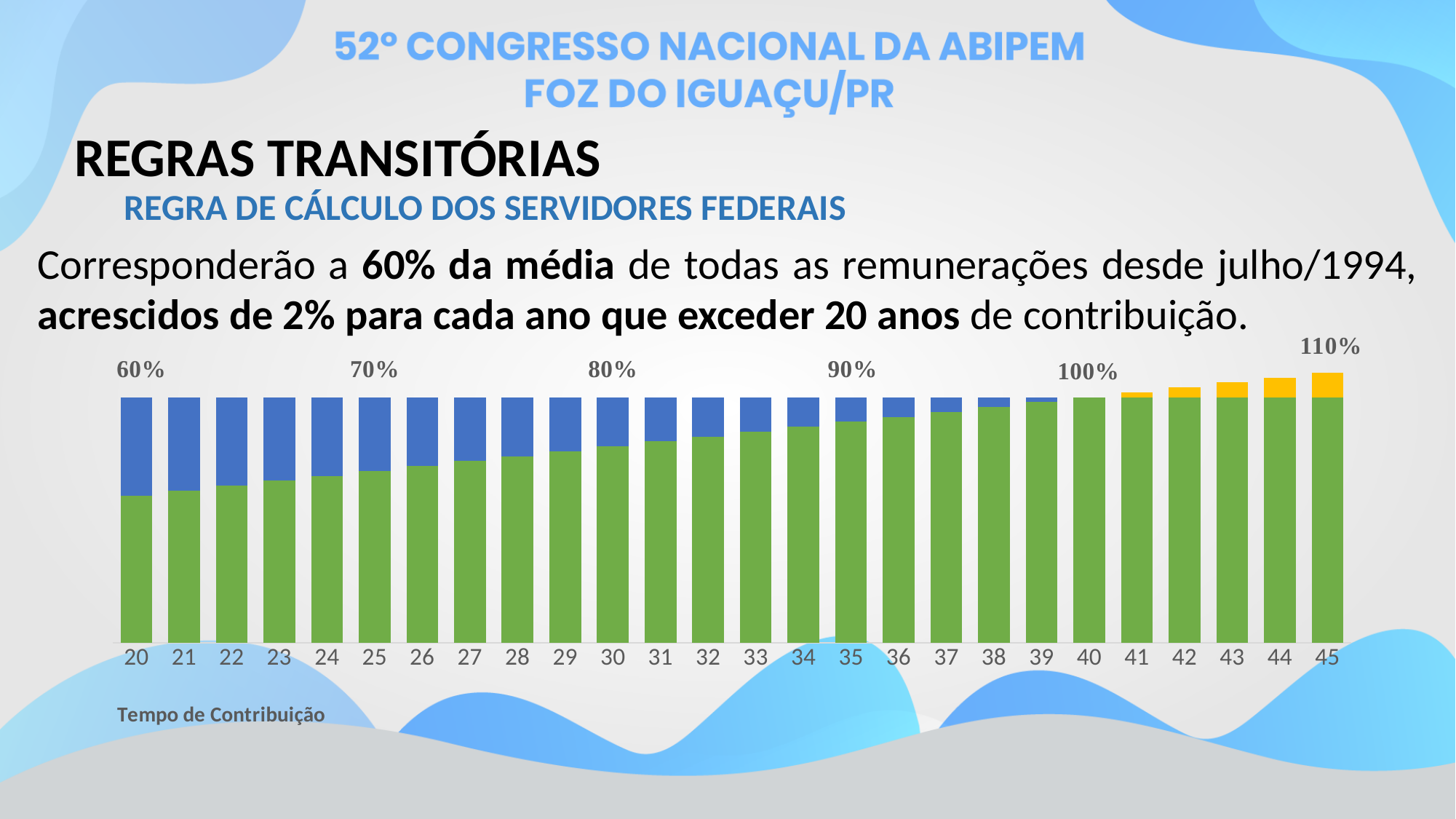
Which has a taller green bar: 25 years or 35 years of contribution? 35 What percentage is labelled above the bar for 40 years of contribution? 100% What is the difference between the labelled percentage at 45 years and at 20 years of contribution? 50% What percentage is labelled above the bar for 20 years of contribution? 60% Which contribution time has the shortest green bar? 20 Do the green bars rise or fall as the contribution time increases from 20 to 45 years? rise How many contribution-time categories are shown on the x axis of the chart? 26 What kind of chart is shown on the slide? bar chart What percentage is labelled above the bar for 30 years of contribution? 80% What percentage is labelled above the bar for 45 years of contribution? 110% What is the label of the x axis of the chart? Tempo de Contribuição